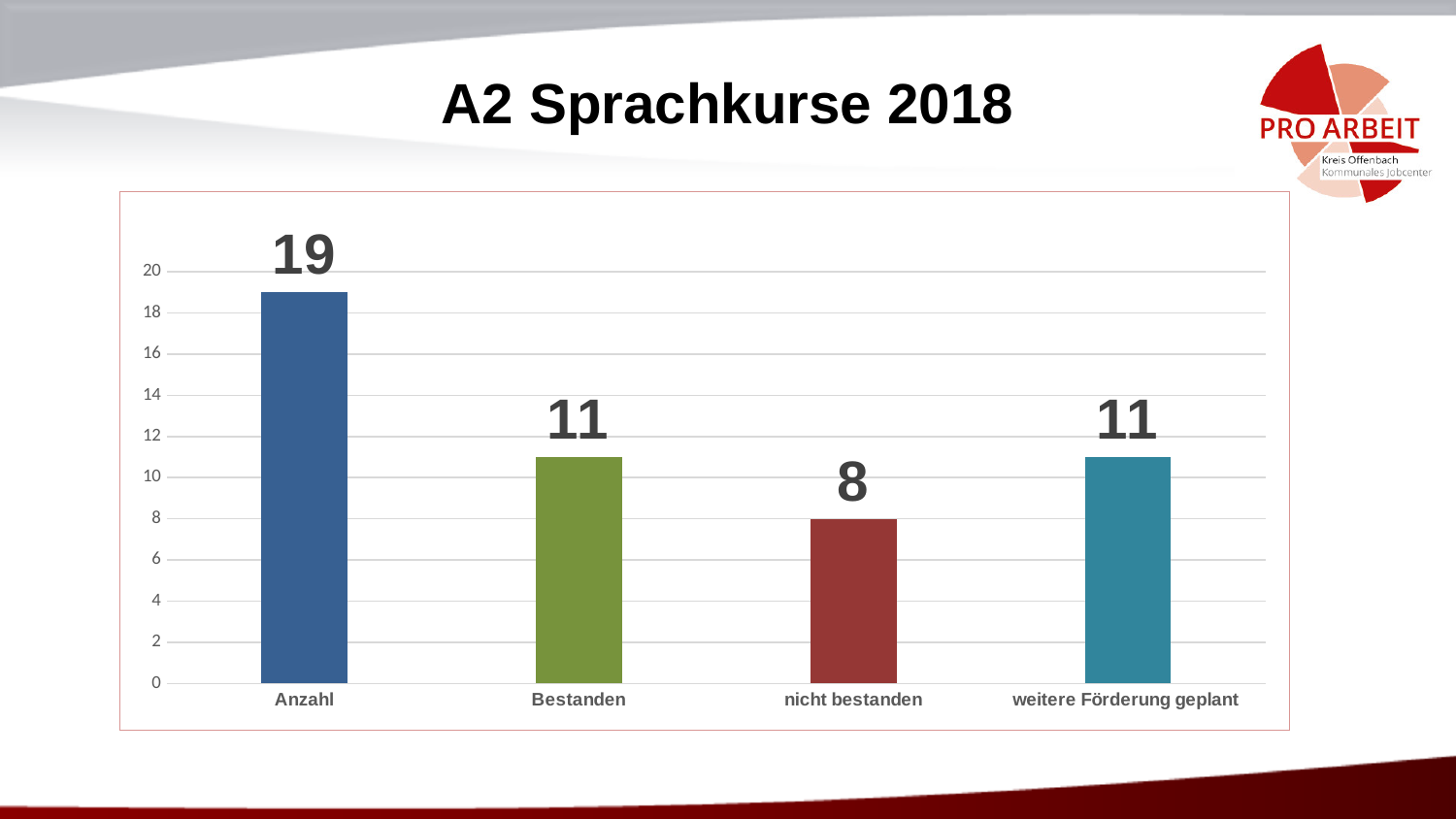
Which category has the lowest value? nicht bestanden What is the difference between the values for Bestanden and nicht bestanden? 3 What kind of chart is shown on the slide? bar chart What is the value for Anzahl? 19 What is the difference between the values for Anzahl and Bestanden? 8 What is the title of the slide? A2 Sprachkurse 2018 What is the value for Bestanden? 11 What is the value for nicht bestanden? 8 What is the value for weitere Förderung geplant? 11 Which category has the highest value? Anzahl Which is larger, the value for Bestanden or the value for nicht bestanden? Bestanden How many categories are shown on the x axis? 4